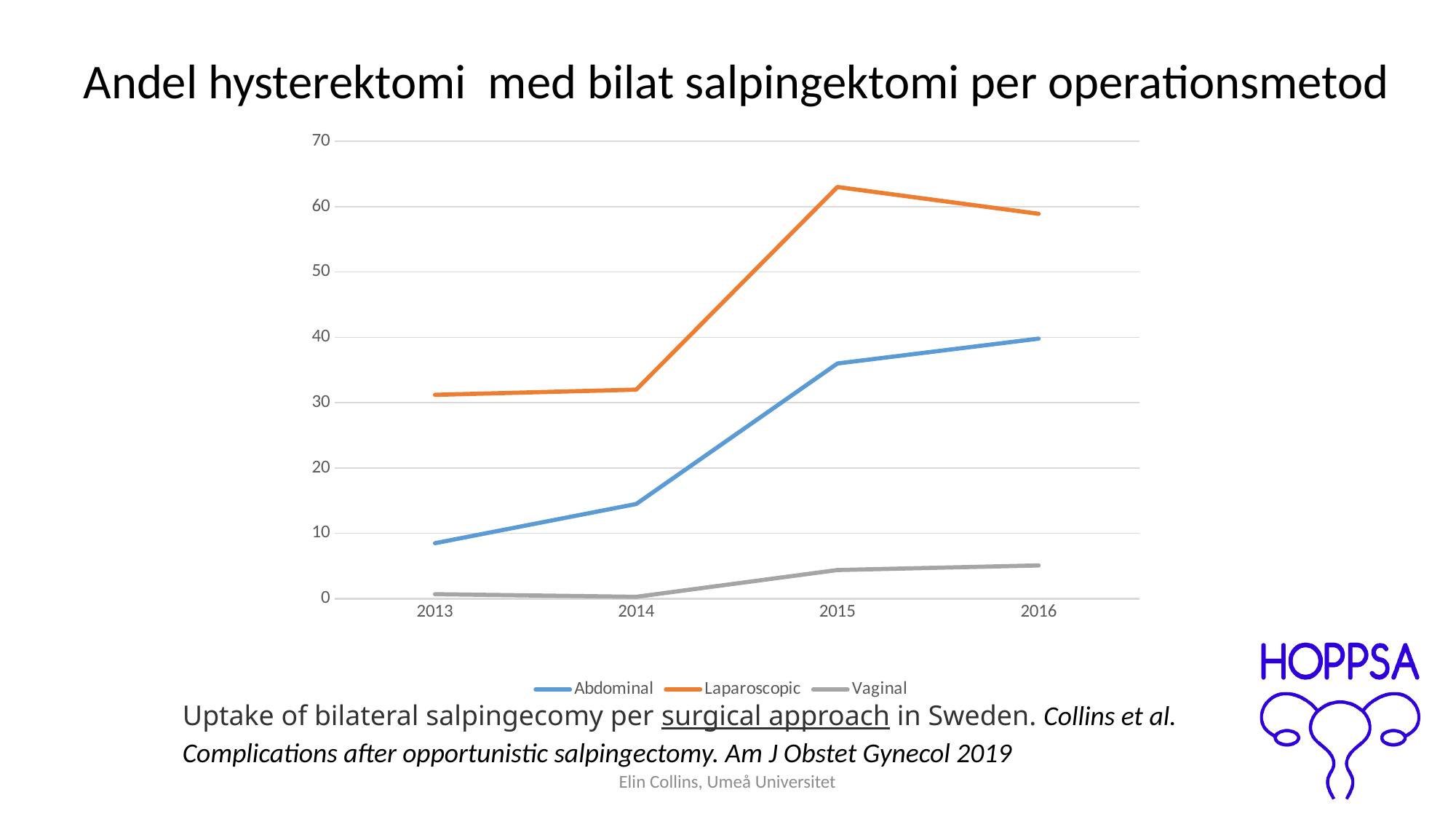
Is the value for Abdominal in 2016 greater or less than 30? greater Which surgical approach has the lowest value in 2016? Vaginal Is the value for Laparoscopic in 2015 greater or less than 60? greater Does the Abdominal line rise or fall from 2013 to 2016? rises Which surgical approach has the highest value in 2015? Laparoscopic How many series does the legend list? 3 How many years are shown on the x axis? 4 What colour is the Laparoscopic line? orange What kind of chart is shown on the slide? line chart Is the value for Abdominal in 2013 greater or less than 10? less For Laparoscopic, which year has the larger value, 2015 or 2016? 2015